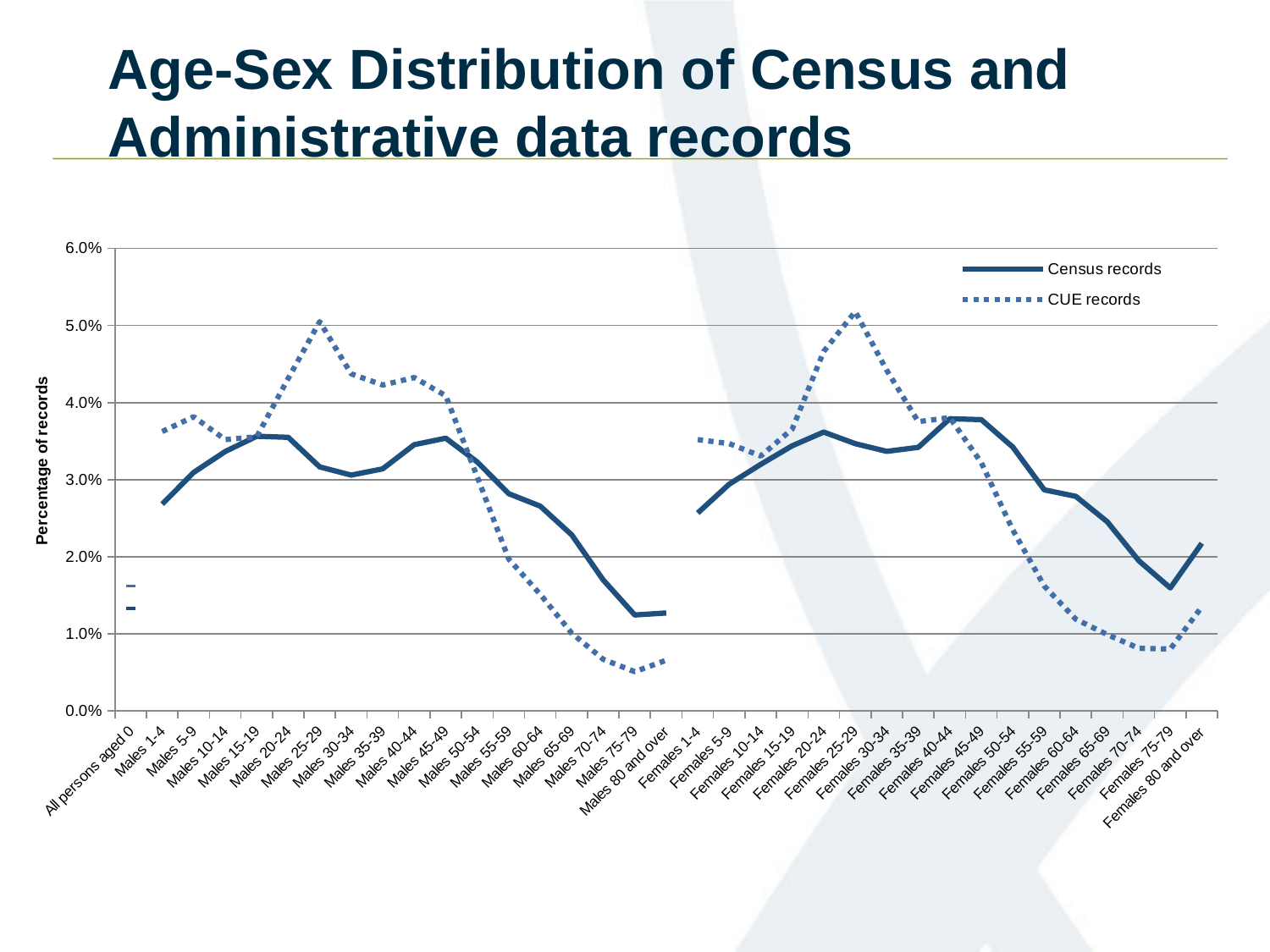
What kind of chart is shown on the slide? line chart Do the Census records values rise or fall from Males 45-49 to Males 75-79? fall For Males 60-64, which series has the larger value, Census records or CUE records? Census records For Males 25-29, which series has the larger value, Census records or CUE records? CUE records Is the Census records value for Males 1-4 greater or less than 3.0%? less Which category has the lowest CUE records value? Males 75-79 Is the Census records value for Females 75-79 greater or less than 2.0%? less How many series does the legend list? 2 What are the two series named in the legend? Census records and CUE records Is the CUE records value for Males 25-29 greater or less than 4.0%? greater What is the title of the vertical axis? Percentage of records